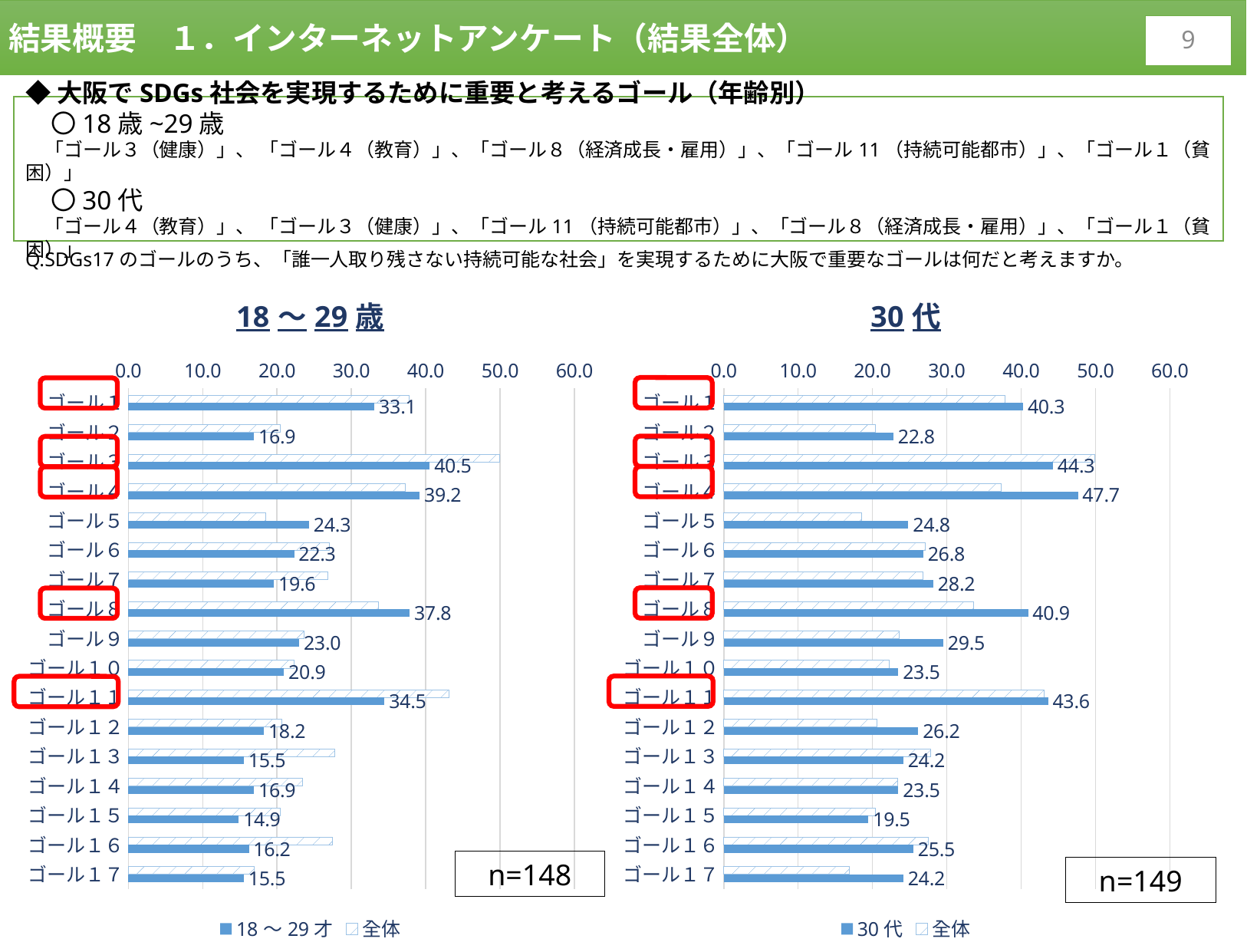
In the 18～29歳 chart, which is larger in the 18～29才 series: ゴール１ or ゴール１１? ゴール１１ What type of chart is the 30代 chart? Bar chart How many series does the legend of the 18～29歳 chart list? 2 In the 30代 chart, what is the difference between the 30代 values for ゴール４ and ゴール３? 3.4 In the 30代 chart, which goal has the highest value in the 30代 series? ゴール４ How many goal categories are shown in the 30代 chart? 17 In the 30代 chart, what is the value for ゴール１１ in the 30代 series? 43.6 In the 18～29歳 chart, is the 全体 value for ゴール３ greater or less than 40.0? greater In the 18～29歳 chart, what is the value for ゴール３ in the 18～29才 series? 40.5 In the 18～29歳 chart, which goal has the highest value in the 18～29才 series? ゴール３ In the 30代 chart, which goal has the lowest value in the 30代 series? ゴール１５ In the 18～29歳 chart, which goal has the lowest value in the 18～29才 series? ゴール１５